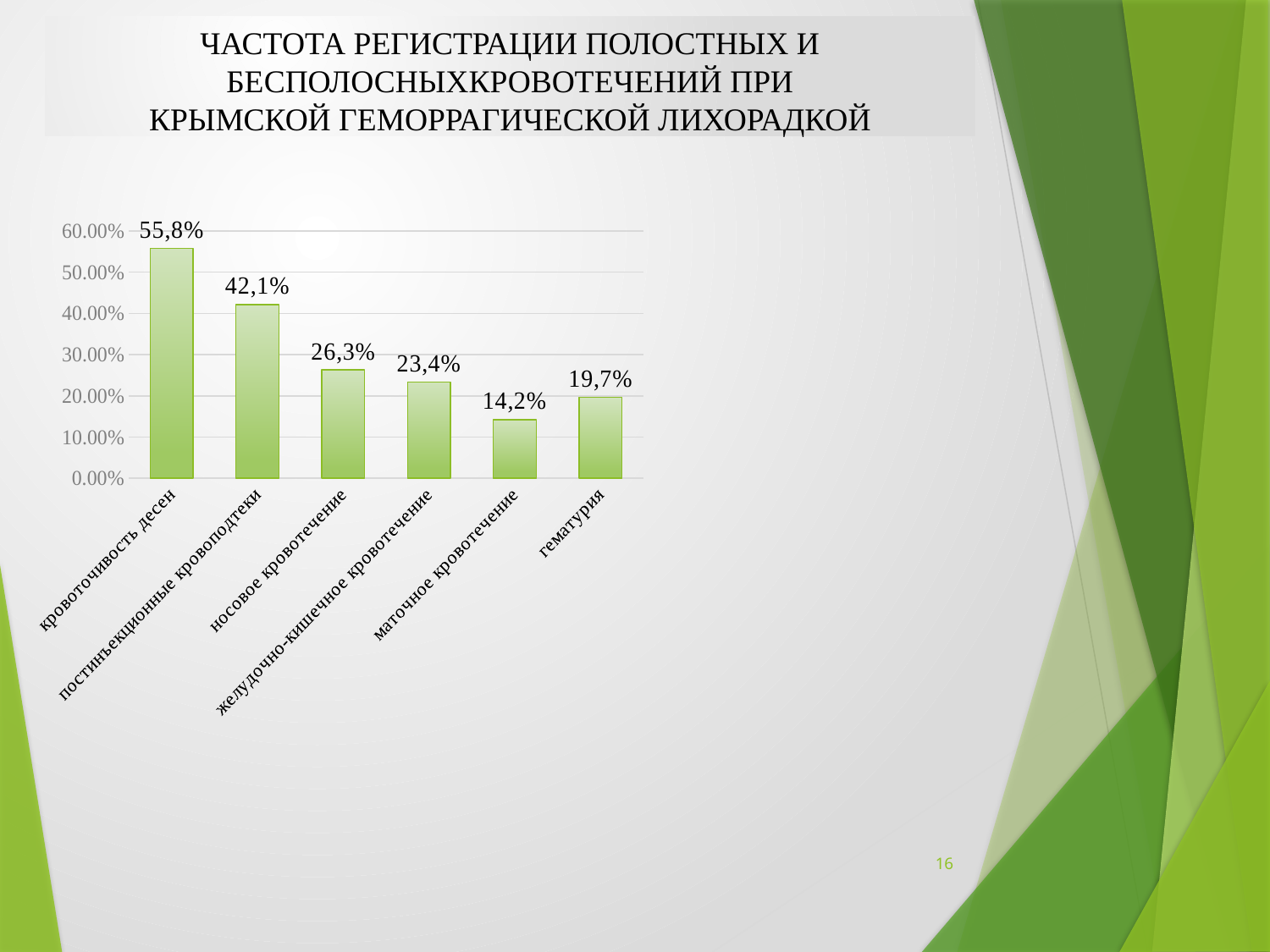
Which category has the highest value? кровоточивость десен What is the value for гематурия? 19,7% What kind of chart is shown on the slide? bar chart What is the difference between the values for кровоточивость десен and постиньекционные кровоподтеки? 13,7% What is the difference between the values for гематурия and маточное кровотечение? 5,5% How many categories are shown in the chart? 6 What is the value for маточное кровотечение? 14,2% Which category has the lowest value? маточное кровотечение Which is larger, the value for желудочно-кишечное кровотечение or the value for гематурия? желудочно-кишечное кровотечение What is the value for кровоточивость десен? 55,8% What is the value for носовое кровотечение? 26,3% Is the value for постиньекционные кровоподтеки greater or less than 40.00%? greater